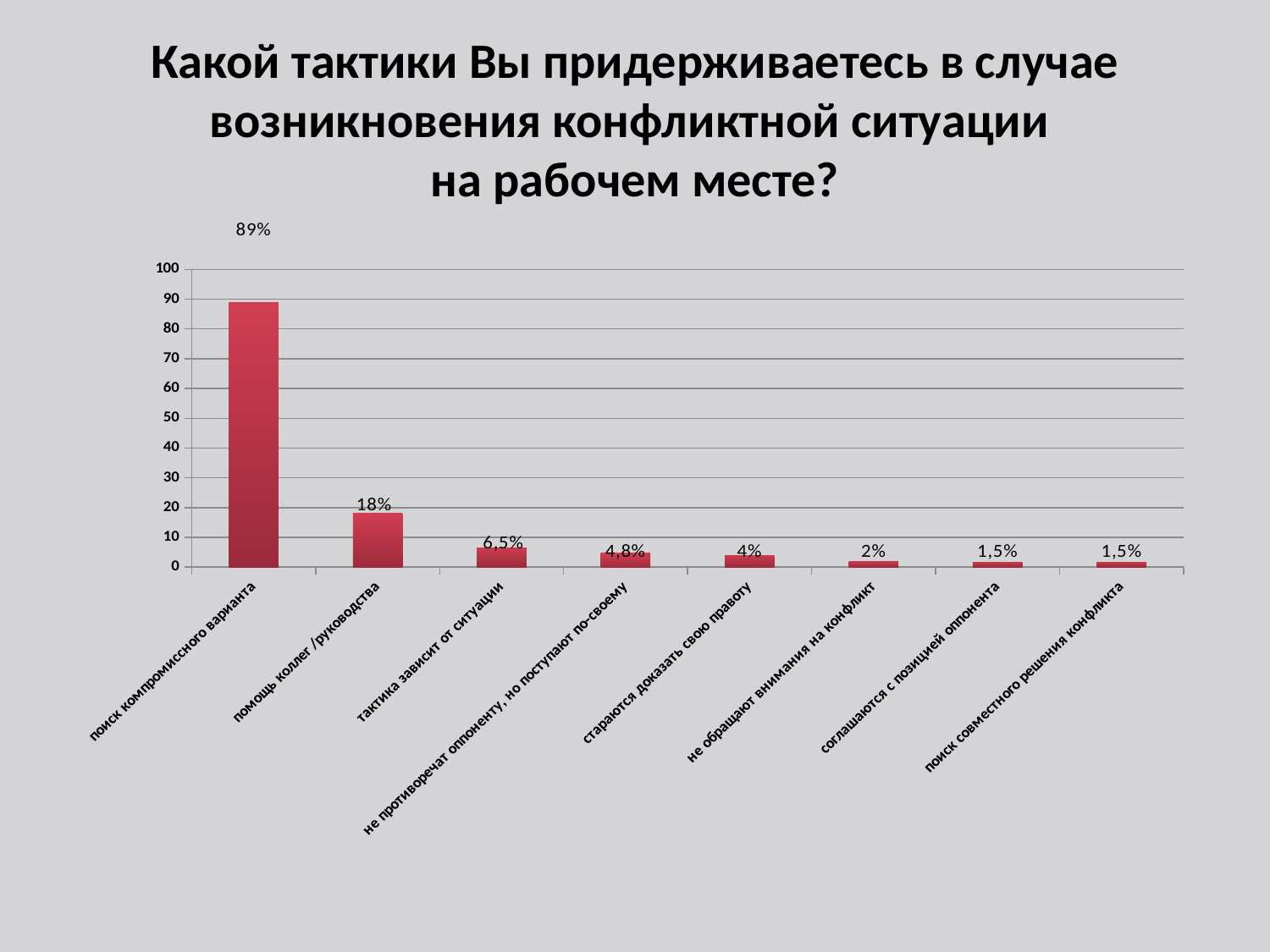
What is the difference between the values for "поиск компромиссного варианта" and "помощь коллег /руководства"? 71% What value is shown for "помощь коллег /руководства"? 18% Which category has the highest value? поиск компромиссного варианта What kind of chart is shown on the slide? bar chart Which is larger: the value for "тактика зависит от ситуации" or the value for "стараются доказать свою правоту"? тактика зависит от ситуации How many categories are shown on the x axis? 8 Is the value for "поиск компромиссного варианта" greater or less than 80? greater What is the difference between the values for "стараются доказать свою правоту" and "не обращают внимания на конфликт"? 2% What value is shown for "не противоречат оппоненту, но поступают по-своему"? 4,8% What value is shown for "поиск компромиссного варианта"? 89% What value is shown for "тактика зависит от ситуации"? 6,5% What value is shown for "не обращают внимания на конфликт"? 2%